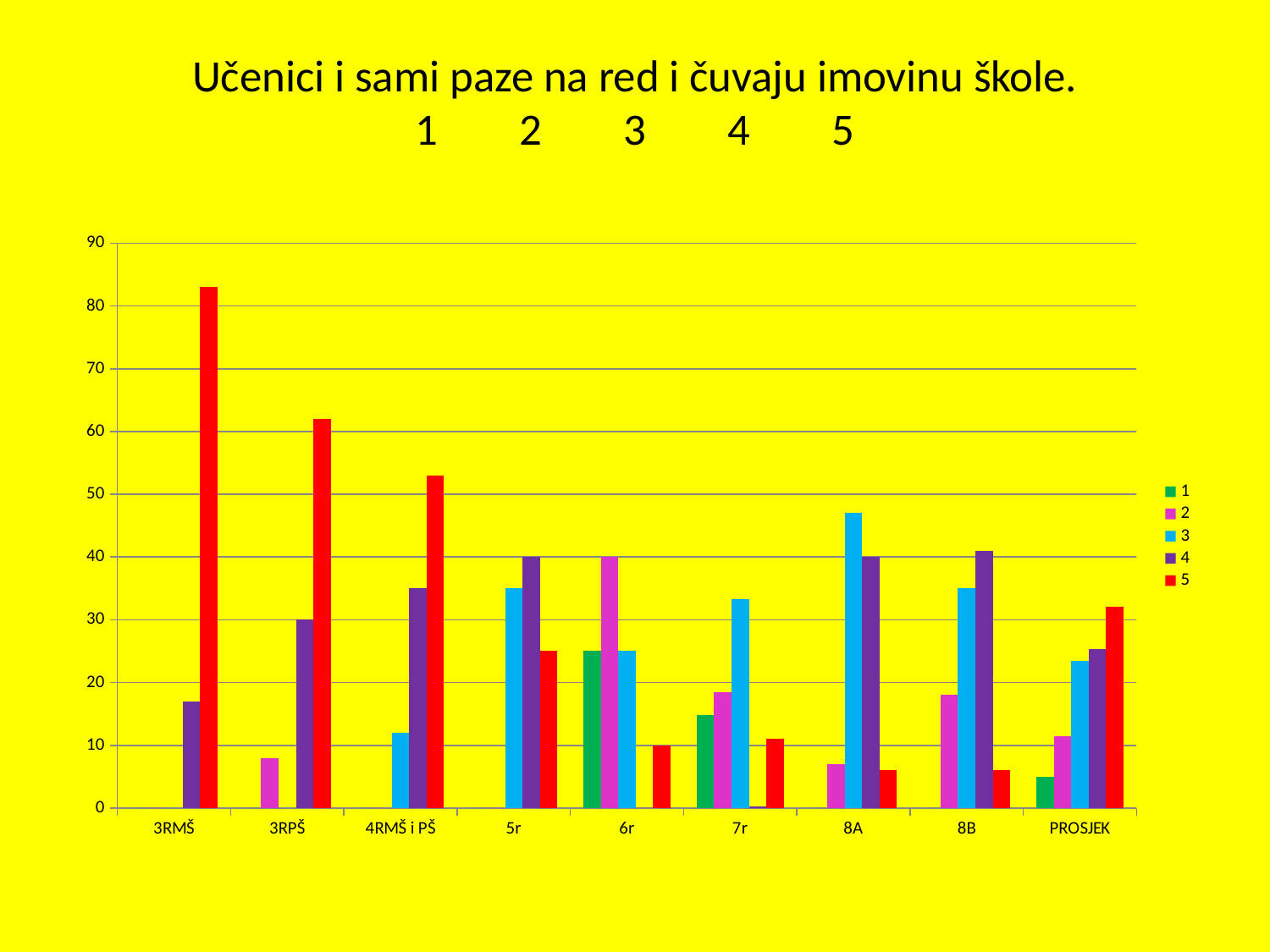
Which category has the highest bar for series 5? 3RMŠ What entries are listed in the legend? 1, 2, 3, 4, 5 Is the value for series 5 in 3RMŠ greater or less than 80? greater In 4RMŠ i PŠ, which is larger: the bar for series 4 or the bar for series 5? series 5 How many series does the legend list? 5 Do the series 5 values rise or fall from 3RMŠ to 3RPŠ to 4RMŠ i PŠ? fall Is the value for series 3 in 8A greater or less than 40? greater In 8B, which is larger: the bar for series 3 or the bar for series 4? series 4 Is the value for series 1 in PROSJEK greater or less than 10? less What kind of chart is shown on the slide? bar chart How many categories are shown along the x axis? 9